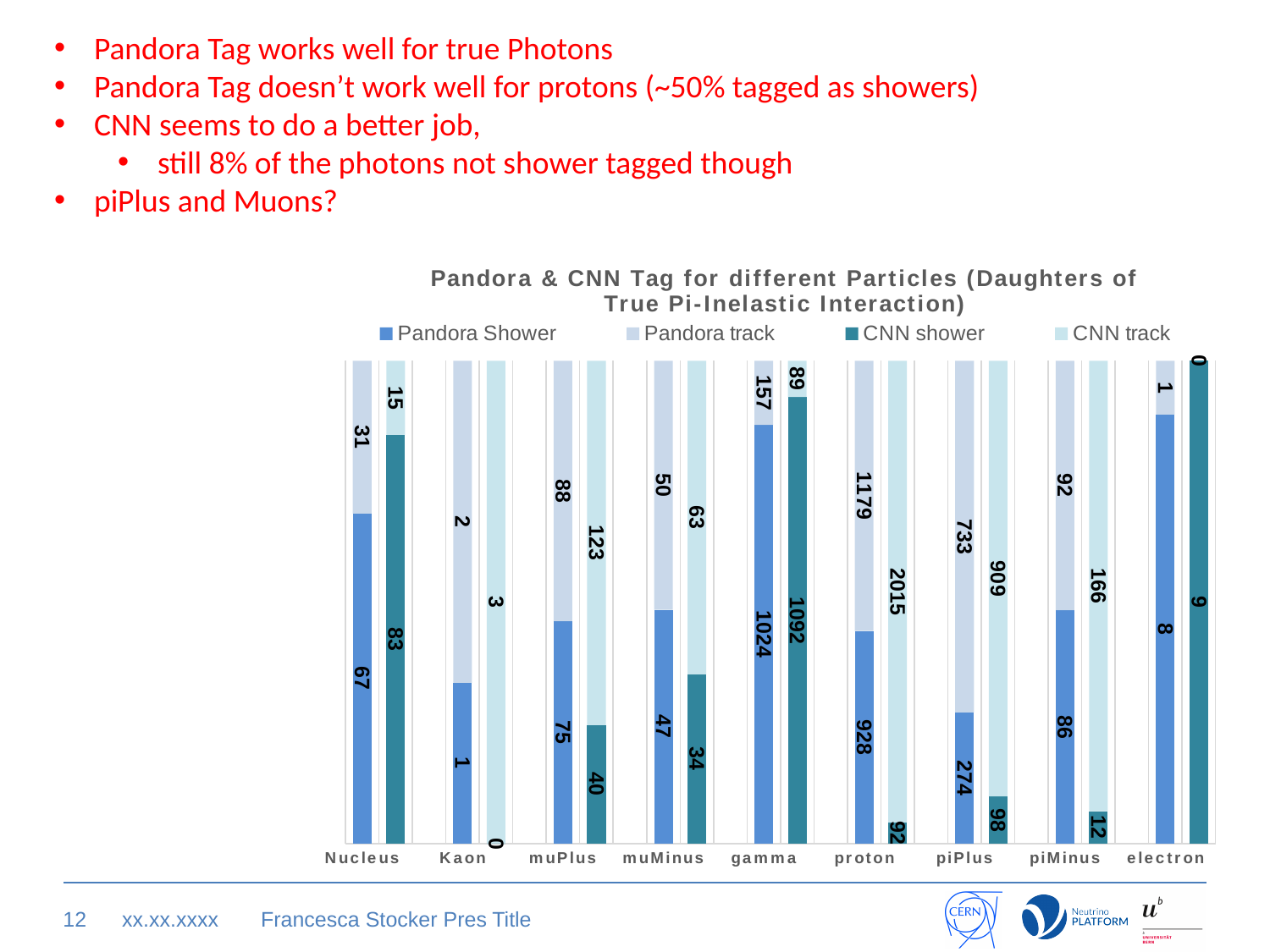
What kind of chart is shown on the slide? Stacked bar chart What is the total of the Pandora Shower and Pandora track values for Nucleus? 98 How many series does the legend list? 4 What is the Pandora track value for muMinus? 50 What is the CNN track value for piPlus? 909 What is the CNN shower value for gamma? 1092 Which particle has the highest Pandora Shower value? gamma Which particle has the highest CNN track value? proton What is the difference between the Pandora track and Pandora Shower values for proton? 251 How many particle categories are shown on the x axis? 9 Which is larger for muPlus, the CNN track value or the CNN shower value? CNN track What is the Pandora Shower value for proton? 928